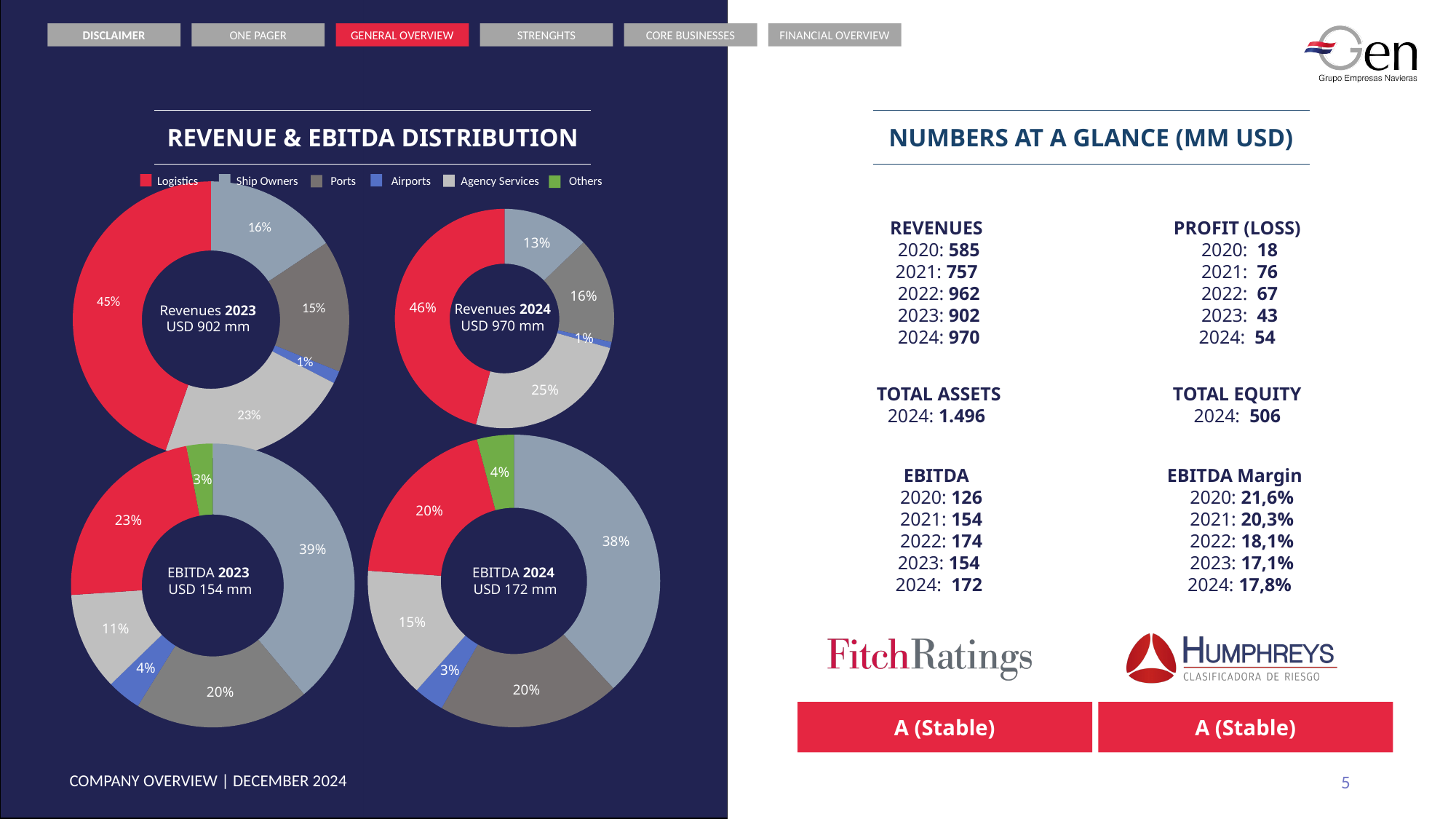
How many segments are shown in the Revenues 2023 donut chart? 5 How many series does the legend of the Revenue & EBITDA Distribution charts list? 6 In the Revenues 2023 donut chart, what share does Logistics hold? 45% In the EBITDA 2023 donut chart, which is larger: the Ports share or the Agency Services share? Ports In the EBITDA 2024 donut chart, which segment has the smallest share? Airports What total value is shown in the centre of the EBITDA 2024 donut chart? USD 172 mm In the Revenues 2024 donut chart, what share does Agency Services hold? 25% In the Revenues 2024 donut chart, what is the difference in percentage points between Logistics and Ship Owners? 33 Which colour represents Logistics in the legend of the Revenue & EBITDA Distribution charts? Red In the EBITDA 2023 donut chart, which segment has the largest share? Ship Owners In the EBITDA 2024 donut chart, what share does Others hold? 4% What type of chart is used for the Revenue & EBITDA Distribution? Donut (pie) chart